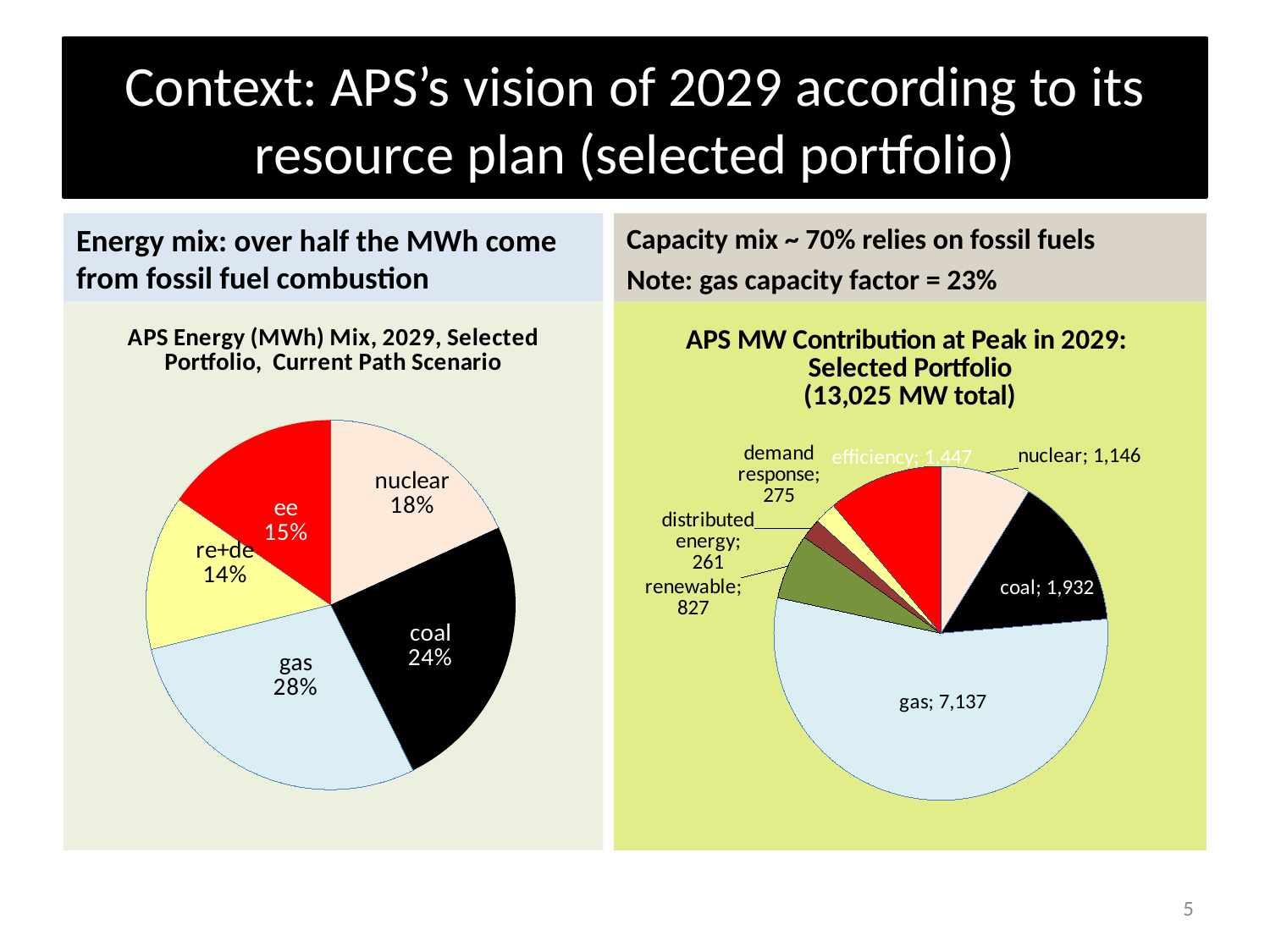
In the APS MW Contribution at Peak in 2029 chart, which is larger, efficiency or nuclear? efficiency In the APS Energy (MWh) Mix, 2029 chart, what share does nuclear have? 18% In the APS Energy (MWh) Mix, 2029 chart, how many slices does the pie have? 5 In the APS MW Contribution at Peak in 2029 chart, what is the difference between gas and coal? 5,205 In the APS Energy (MWh) Mix, 2029 chart, which category has the largest share? gas In the APS MW Contribution at Peak in 2029 chart, what is the value for renewable? 827 In the APS Energy (MWh) Mix, 2029 chart, which category has the smallest share? re+de In the APS Energy (MWh) Mix, 2029 chart, what is the difference in percentage points between gas and coal? 4 In the APS MW Contribution at Peak in 2029 chart, what is the value for coal? 1,932 In the APS Energy (MWh) Mix, 2029 chart, what share does gas have? 28% What type of chart is the APS MW Contribution at Peak in 2029 chart? pie chart In the APS MW Contribution at Peak in 2029 chart, which category has the smallest value? distributed energy